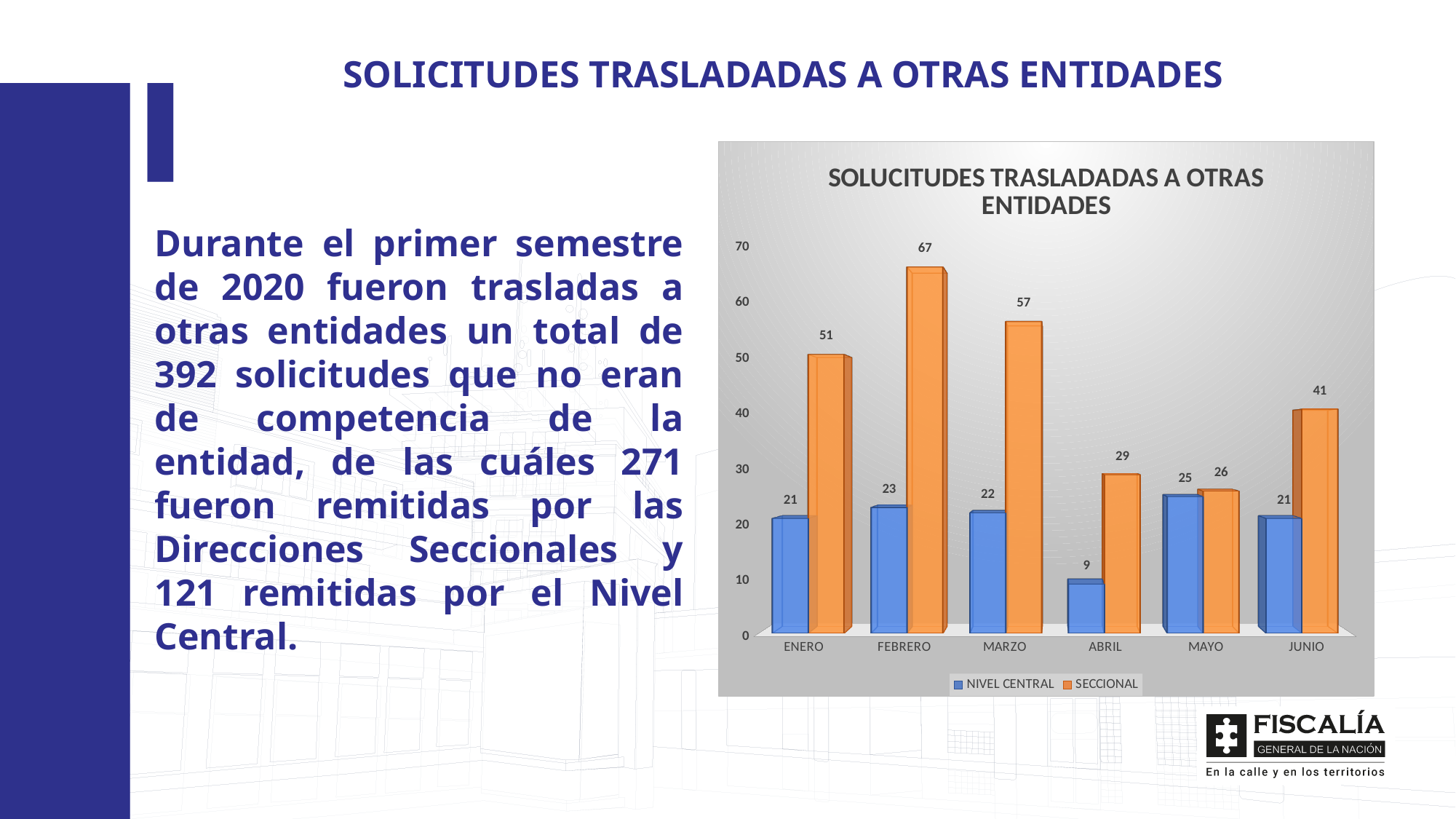
How many months are shown on the x axis? 6 What kind of chart is shown on the slide? bar chart What is the SECCIONAL value for JUNIO? 41 What is the difference between the SECCIONAL and NIVEL CENTRAL values for MARZO? 35 What colour are the SECCIONAL bars? orange Which is larger in MAYO, NIVEL CENTRAL or SECCIONAL? SECCIONAL Is the SECCIONAL value for ENERO greater or less than 40? greater How many series does the legend list? 2 What is the NIVEL CENTRAL value for ABRIL? 9 What is the SECCIONAL value for FEBRERO? 67 Which month has the highest SECCIONAL value? FEBRERO Which month has the lowest NIVEL CENTRAL value? ABRIL